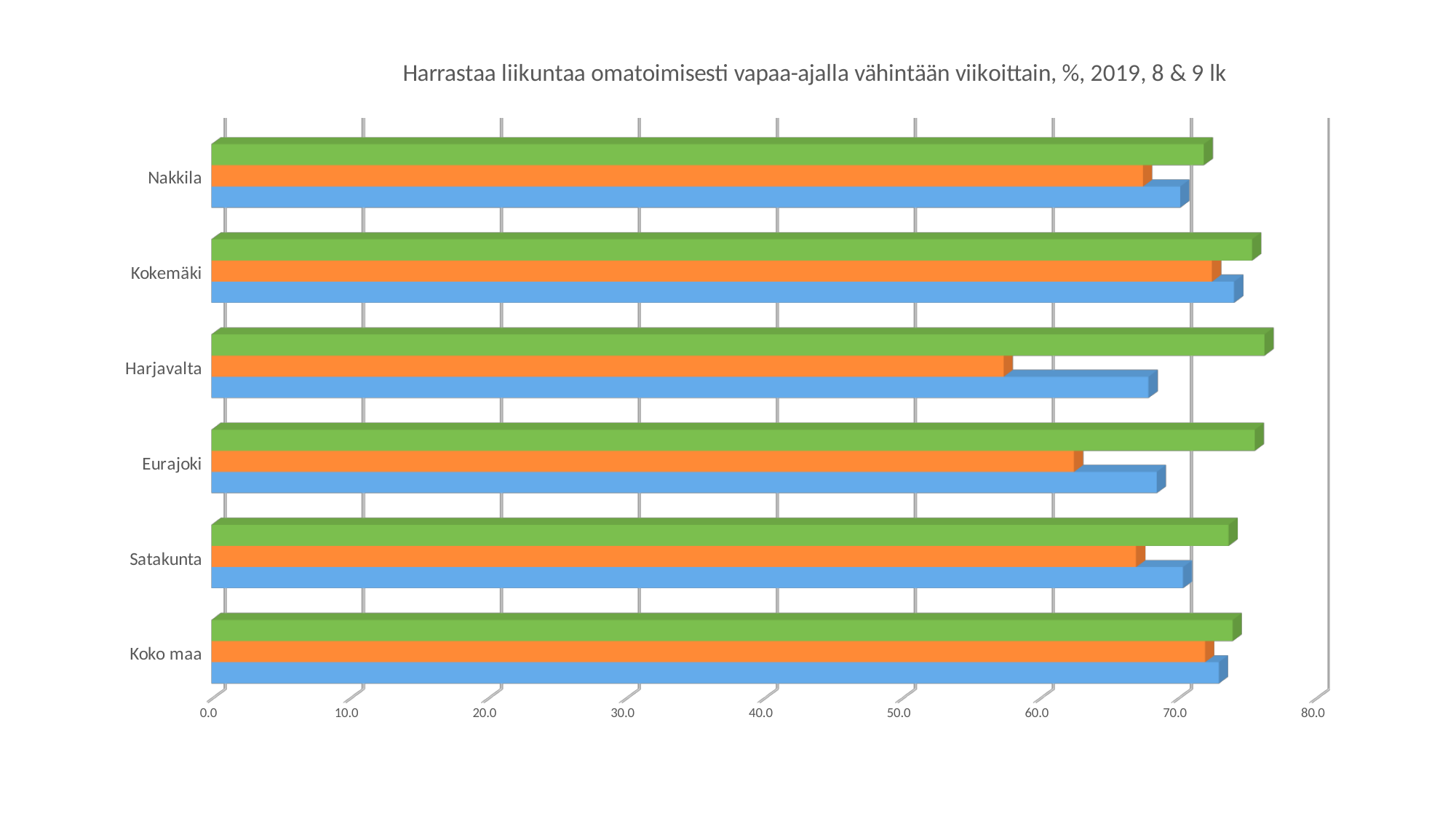
Is the value of the blue bar for Harjavalta greater or less than 70? less Is the value of the green bar for Nakkila greater or less than 70? greater Is the value of the orange bar for Harjavalta greater or less than 60? less For Harjavalta, which is larger: the orange bar or the blue bar? the blue bar What kind of chart is shown on the slide? bar chart Which category has the lowest value for the orange bars? Harjavalta What is the title of the chart? Harrastaa liikuntaa omatoimisesti vapaa-ajalla vähintään viikoittain, %, 2019, 8 & 9 lk What is the highest value shown on the horizontal axis of the chart? 80.0 How many categories are shown on the vertical axis of the chart? 6